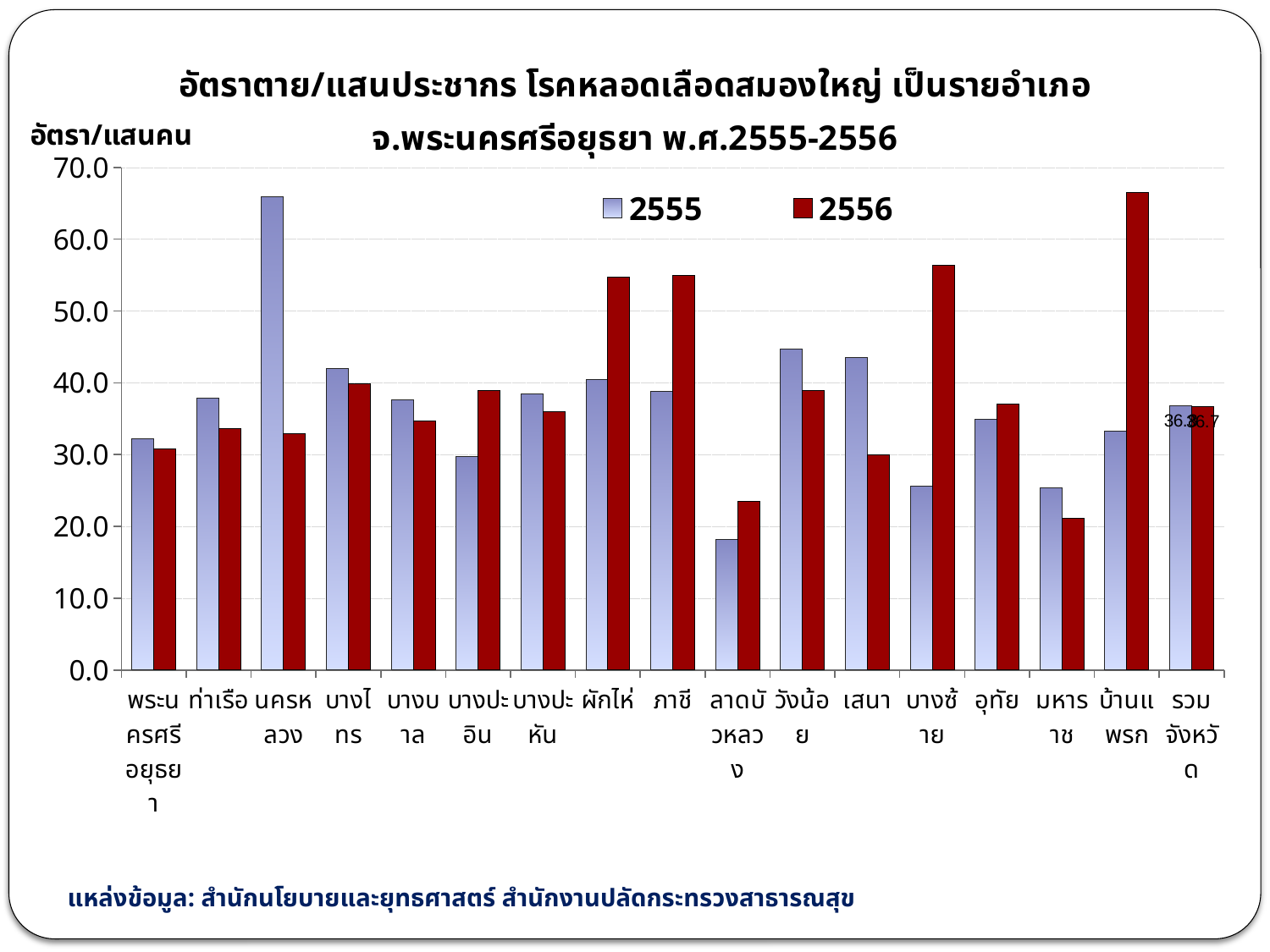
For ผักไห่, which series has the larger value, 2555 or 2556? 2556 Which category has the highest value for the 2555 series? นครหลวง What kind of chart is shown on the slide? bar chart For เสนา, which series has the larger value, 2555 or 2556? 2555 Is the 2555 value for ลาดบัวหลวง greater or less than 20? less Is the 2555 value for นครหลวง greater or less than 60? greater How many categories are shown along the x axis? 17 Which category has the lowest value for the 2555 series? ลาดบัวหลวง Which category has the lowest value for the 2556 series? มหาราช Which category has the highest value for the 2556 series? บ้านแพรก What are the two series named in the legend? 2555 and 2556 How many series does the legend list? 2